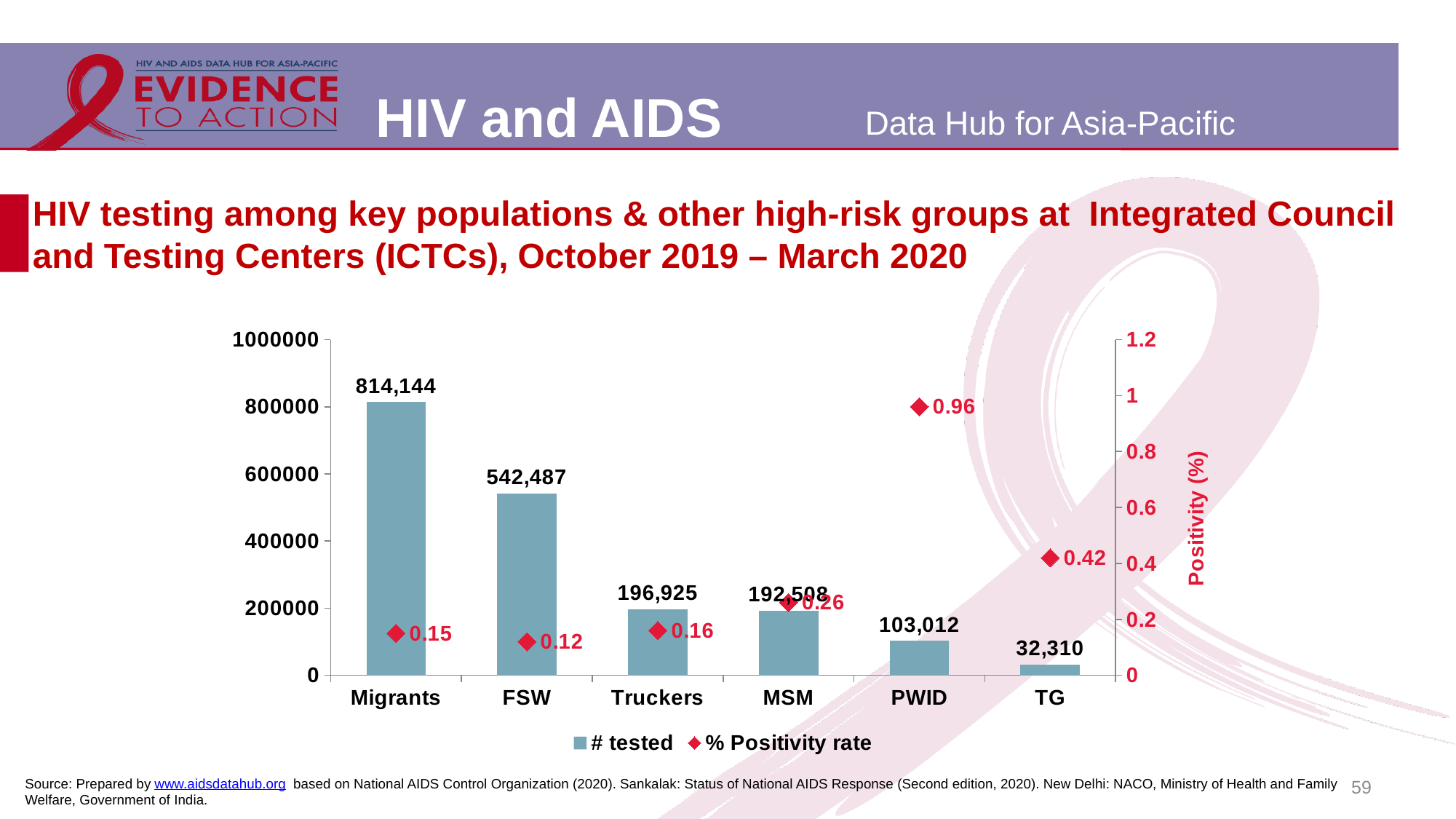
What is the % positivity rate for PWID? 0.96 Which group had more people tested, Truckers or MSM? Truckers How many people were tested among TG? 32,310 Which group has the lowest % positivity rate? FSW How many groups are shown on the x axis? 6 What is the difference in number tested between Migrants and FSW? 271,657 What is the label of the right-hand vertical axis? Positivity (%) Which group has the highest % positivity rate? PWID Which group has the highest number tested? Migrants How many people were tested among Migrants? 814,144 How many series does the legend list? 2 What is the % positivity rate for FSW? 0.12